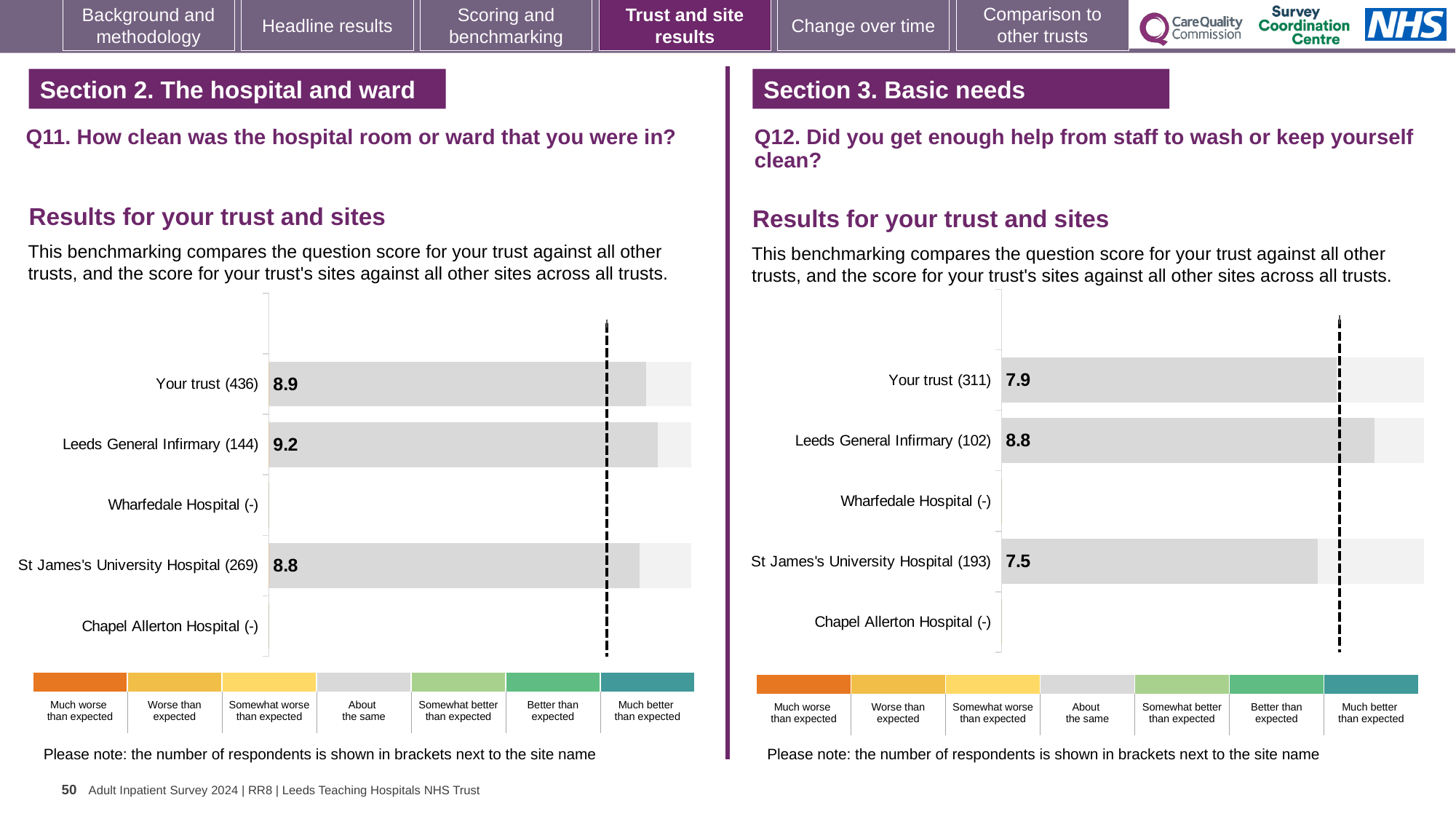
On the Q12 chart (right), what is the score for Leeds General Infirmary? 8.8 On the Q12 chart (right), which site has the lowest score among those with a value shown? St James's University Hospital On the Q11 chart (left), which site or trust has the highest score? Leeds General Infirmary On the Q11 chart (left), what is the score for St James's University Hospital? 8.8 What kind of chart is used on the Q11 chart (left)? Bar chart On the Q12 chart (right), what is the difference between the Leeds General Infirmary score and the Your trust score? 0.9 On the Q12 chart (right), what is the score for St James's University Hospital? 7.5 On the Q11 chart (left), what is the score for Your trust? 8.9 On the Q12 chart (right), what is the score for Your trust? 7.9 On the Q11 chart (left), what is the score for Leeds General Infirmary? 9.2 On the Q11 chart (left), what is the difference between the Leeds General Infirmary score and the St James's University Hospital score? 0.4 On the Q12 chart (right), which is larger: the score for Your trust or the score for St James's University Hospital? Your trust